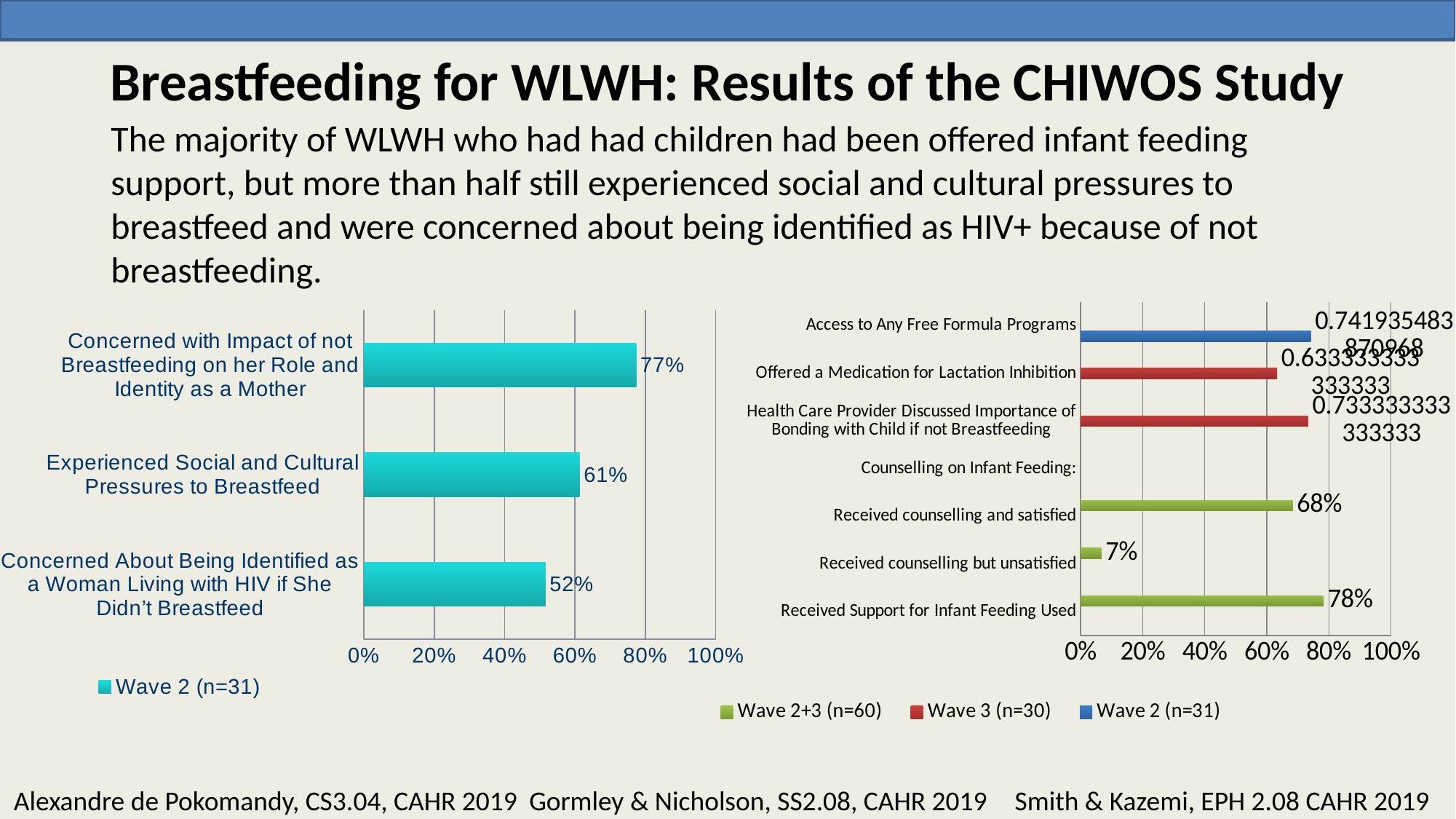
In the left chart, how many categories are plotted? 3 What type of chart is the right chart? Bar chart In the left chart, what is the difference between the highest and lowest values? 25% In the left chart, which category has the highest value? Concerned with Impact of not Breastfeeding on her Role and Identity as a Mother In the right chart, what is the value for 'Received Support for Infant Feeding Used'? 78% In the right chart, which is larger: 'Received counselling and satisfied' or 'Received counselling but unsatisfied'? Received counselling and satisfied In the left chart, what is the value for 'Concerned About Being Identified as a Woman Living with HIV if She Didn't Breastfeed'? 52% In the left chart, what series does the legend list? Wave 2 (n=31) In the right chart, what is the value for 'Received counselling but unsatisfied'? 7% In the right chart, how many series does the legend list? 3 In the left chart, what is the value for 'Experienced Social and Cultural Pressures to Breastfeed'? 61% In the right chart, is the value for 'Offered a Medication for Lactation Inhibition' greater or less than 80%? less